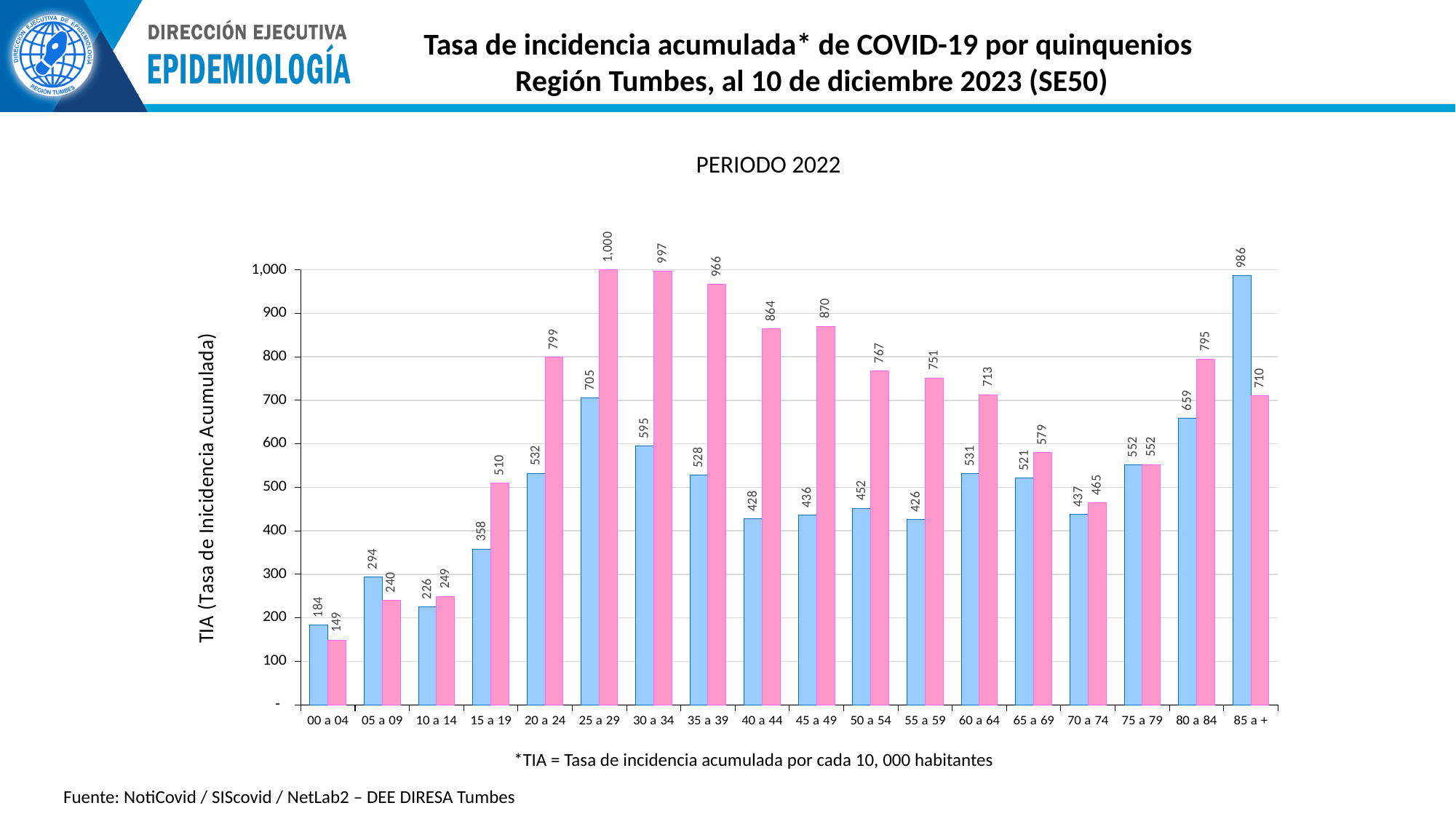
What is the label of the y axis? TIA (Tasa de Incidencia Acumulada) What kind of chart is shown on the slide? bar chart What is the title shown above the chart? PERIODO 2022 What is the difference between the pink and blue bars for the 85 a + age group? 276 How many age groups are shown on the x axis? 18 What is the value of the pink bar for the 40 a 44 age group? 864 What is the value of the blue bar for the 25 a 29 age group? 705 Which age group has the lowest pink bar? 00 a 04 Which age group has the highest blue bar? 85 a + Is the value of the pink bar for the 35 a 39 age group greater or less than 900? greater Which age group has the highest pink bar? 25 a 29 Which is larger for the 10 a 14 age group, the blue bar or the pink bar? the pink bar